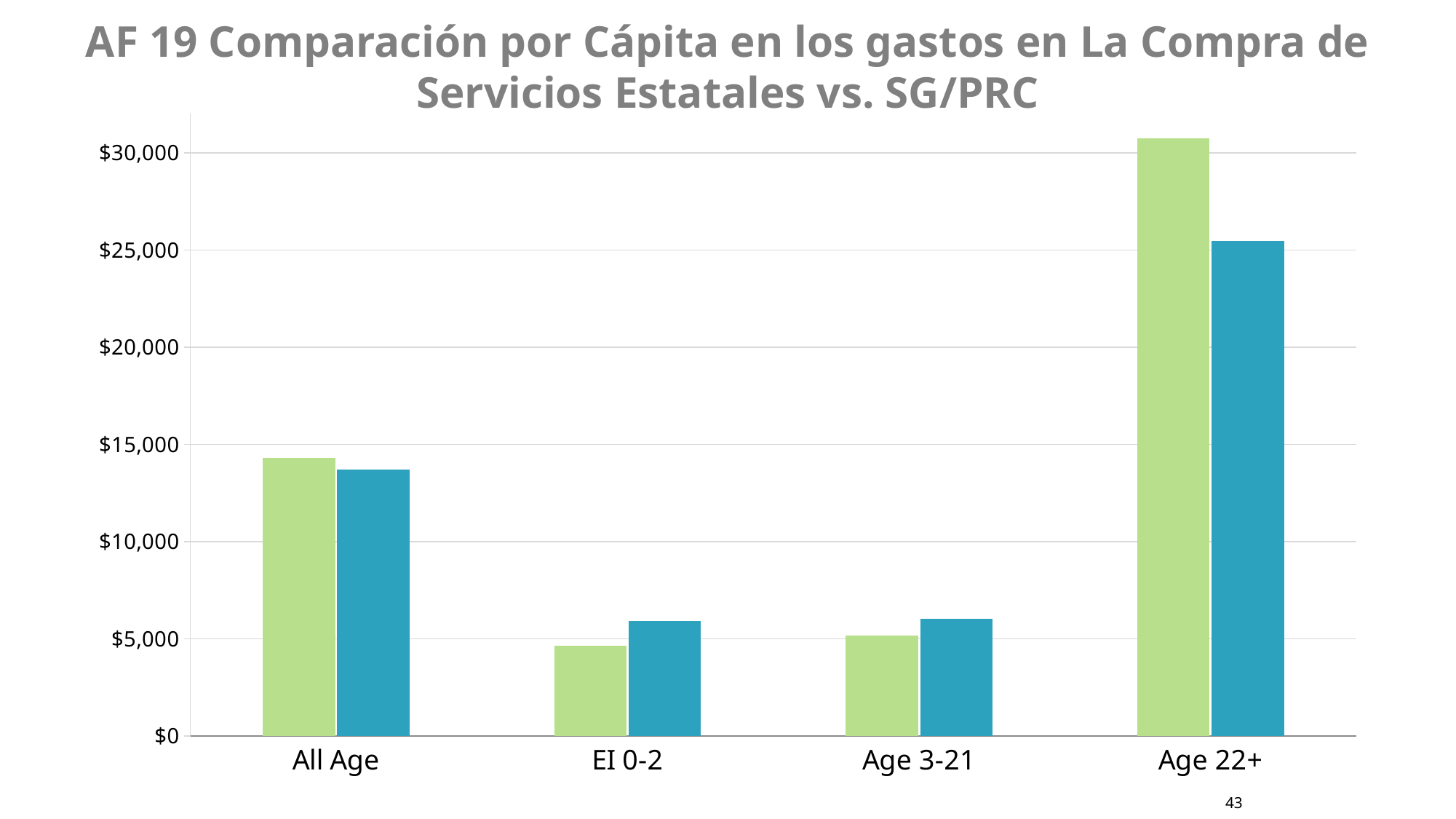
Is the green bar for All Age greater or less than $15,000? less Is the blue bar for Age 22+ greater or less than $25,000? greater How many categories are shown on the x axis? 4 What is the title of the chart? AF 19 Comparación por Cápita en los gastos en La Compra de Servicios Estatales vs. SG/PRC What kind of chart is shown on the slide? bar chart Which category has the shortest green bar? EI 0-2 Is the blue bar for Age 3-21 greater or less than $5,000? greater For EI 0-2, which bar is taller, the green one or the blue one? blue Which category has the tallest bars? Age 22+ For Age 22+, which bar is taller, the green one or the blue one? green